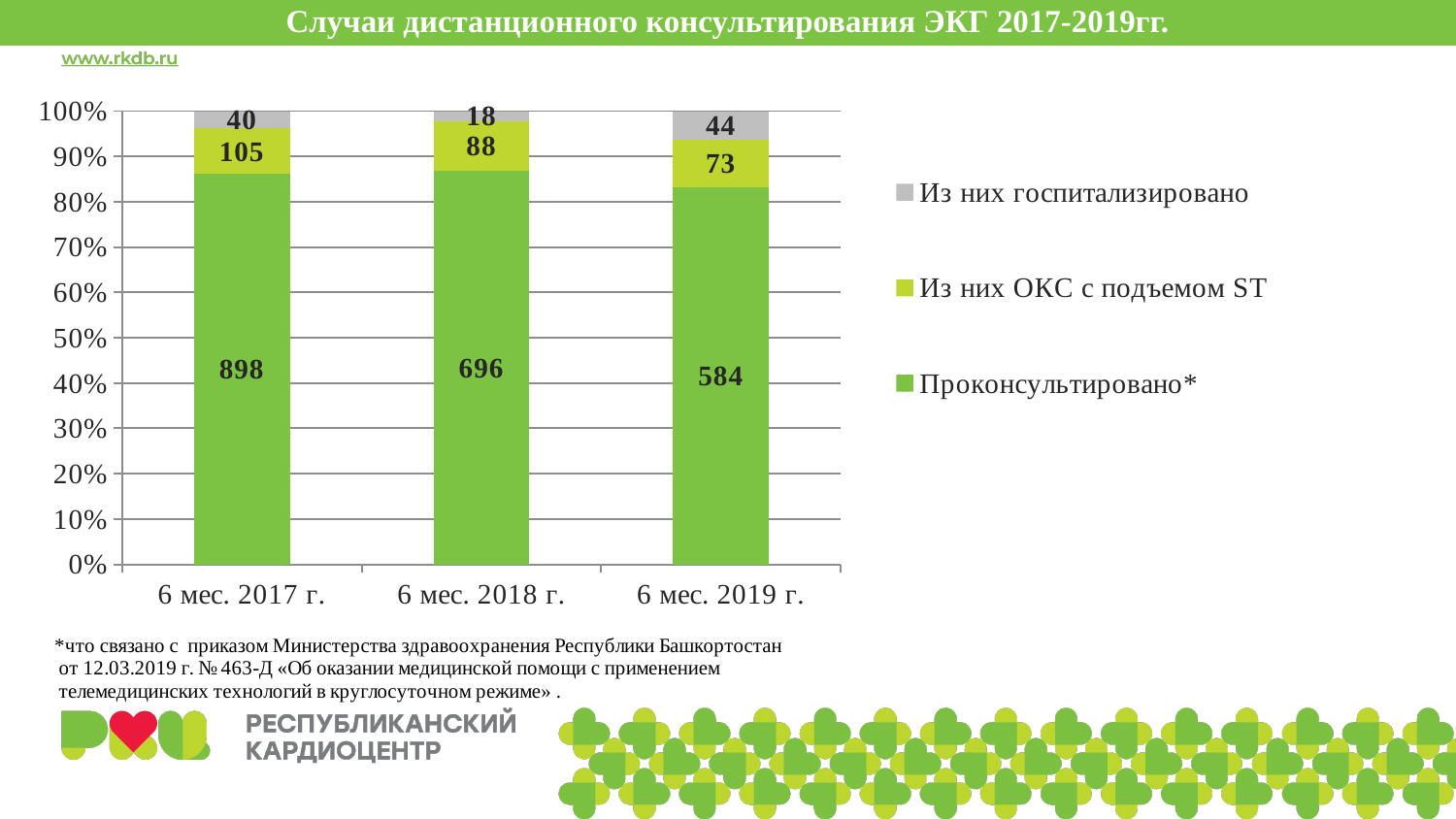
Which is larger: Из них ОКС с подъемом ST for 6 мес. 2017 г. or for 6 мес. 2019 г.? 6 мес. 2017 г. Does the Проконсультировано* value rise or fall from 6 мес. 2017 г. to 6 мес. 2019 г.? Fall How many series does the legend list? 3 What is the value of Из них ОКС с подъемом ST for 6 мес. 2018 г.? 88 How many categories are shown on the x axis? 3 Which category has the lowest value for Из них госпитализировано? 6 мес. 2018 г. Which category has the highest value for Проконсультировано*? 6 мес. 2017 г. What is the difference between the Проконсультировано* values for 6 мес. 2017 г. and 6 мес. 2019 г.? 314 What type of chart is shown on the slide? Stacked bar chart What is the value of Из них госпитализировано for 6 мес. 2019 г.? 44 What is the total of the stacked bar for 6 мес. 2018 г.? 802 What is the value of Проконсультировано* for 6 мес. 2017 г.? 898